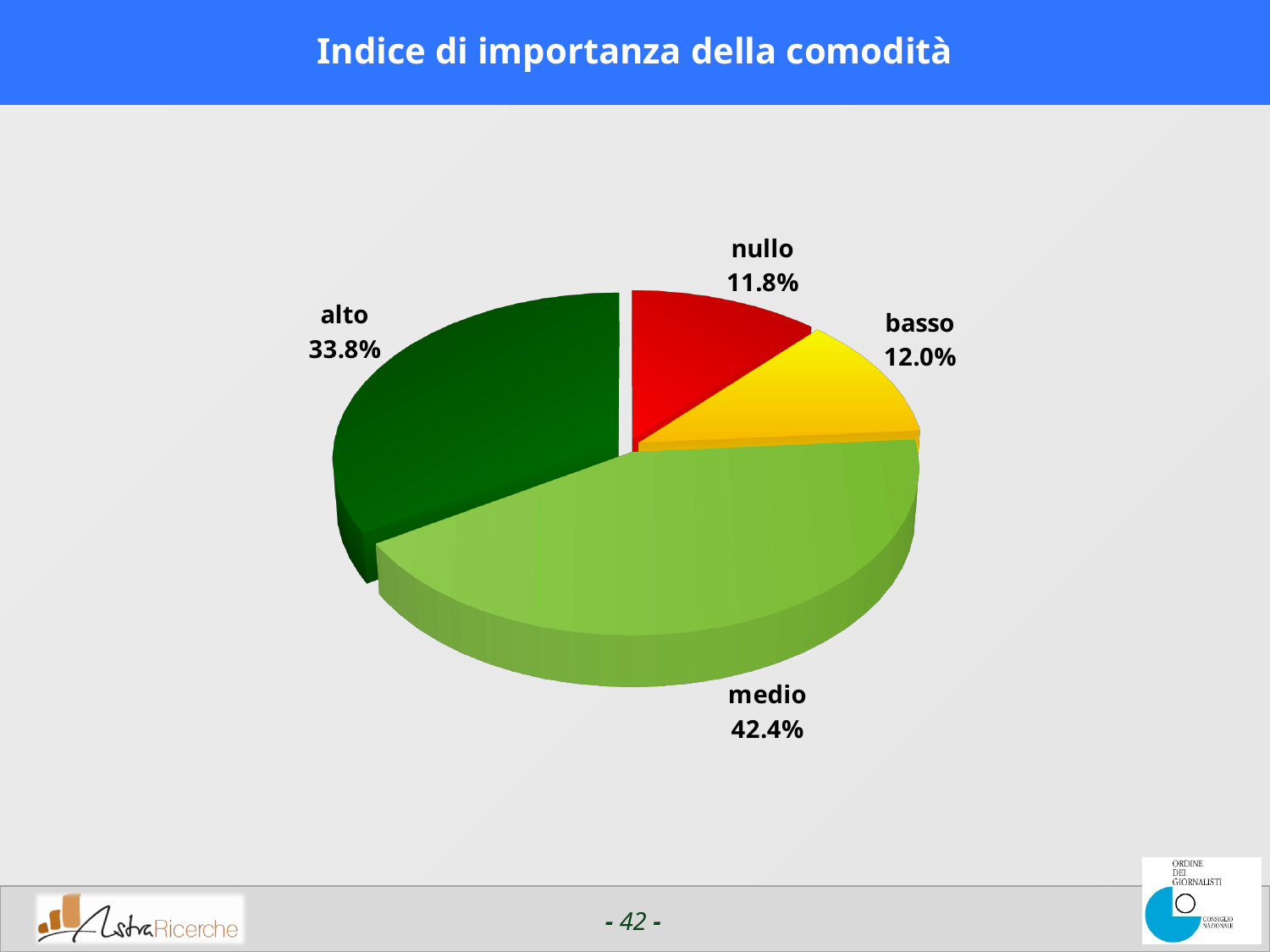
Which category has the smallest share of the pie? nullo What colour is the 'nullo' slice? red How many slices does the pie chart have? 4 What percentage is shown for the 'medio' slice? 42.4% What percentage is shown for the 'basso' slice? 12.0% What percentage is shown for the 'nullo' slice? 11.8% Which is larger, the share for 'alto' or the share for 'basso'? alto What is the title of the chart? Indice di importanza della comodità What percentage is shown for the 'alto' slice? 33.8% Which category has the largest share of the pie? medio What is the difference in percentage points between 'medio' and 'alto'? 8.6 What kind of chart is shown on the slide? pie chart